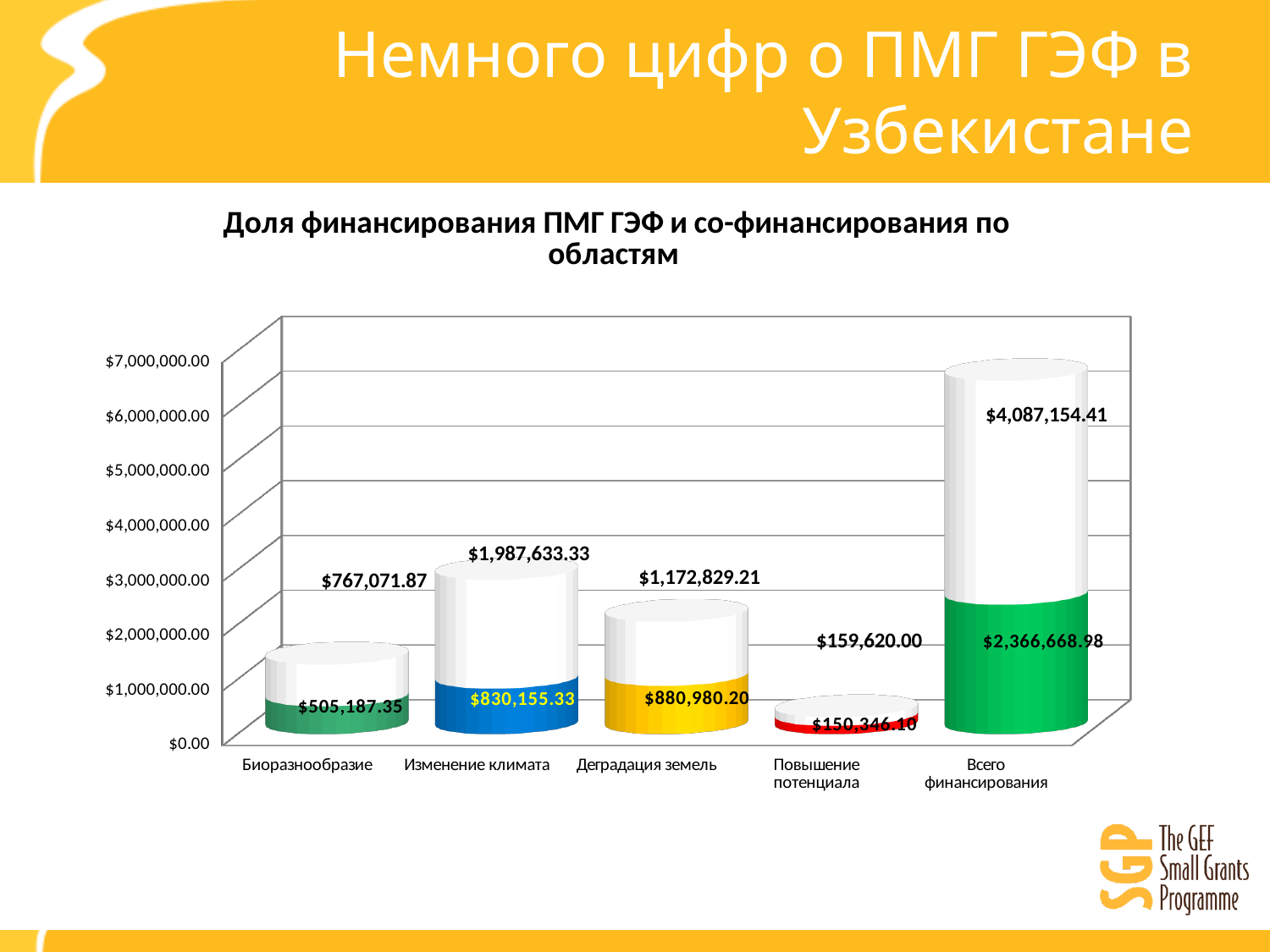
How many categories are shown on the x axis of the chart? 5 What is the title of the chart? Доля финансирования ПМГ ГЭФ и со-финансирования по областям What is the total of the stacked bar for Деградация земель? $2,053,809.41 What is the difference between the upper and lower segments for Изменение климата? $1,157,478.00 Which is larger: the lower (coloured) segment for Деградация земель or for Изменение климата? Деградация земель What is the value of the upper (white) segment for Изменение климата? $1,987,633.33 What is the value of the lower (coloured) segment for Биоразнообразие? $505,187.35 Which category has the tallest bar overall? Всего финансирования What is the value of the lower (coloured) segment for Повышение потенциала? $150,346.10 What kind of chart is shown on the slide? Stacked bar chart Which category has the shortest bar overall? Повышение потенциала What is the value of the upper (white) segment for Всего финансирования? $4,087,154.41